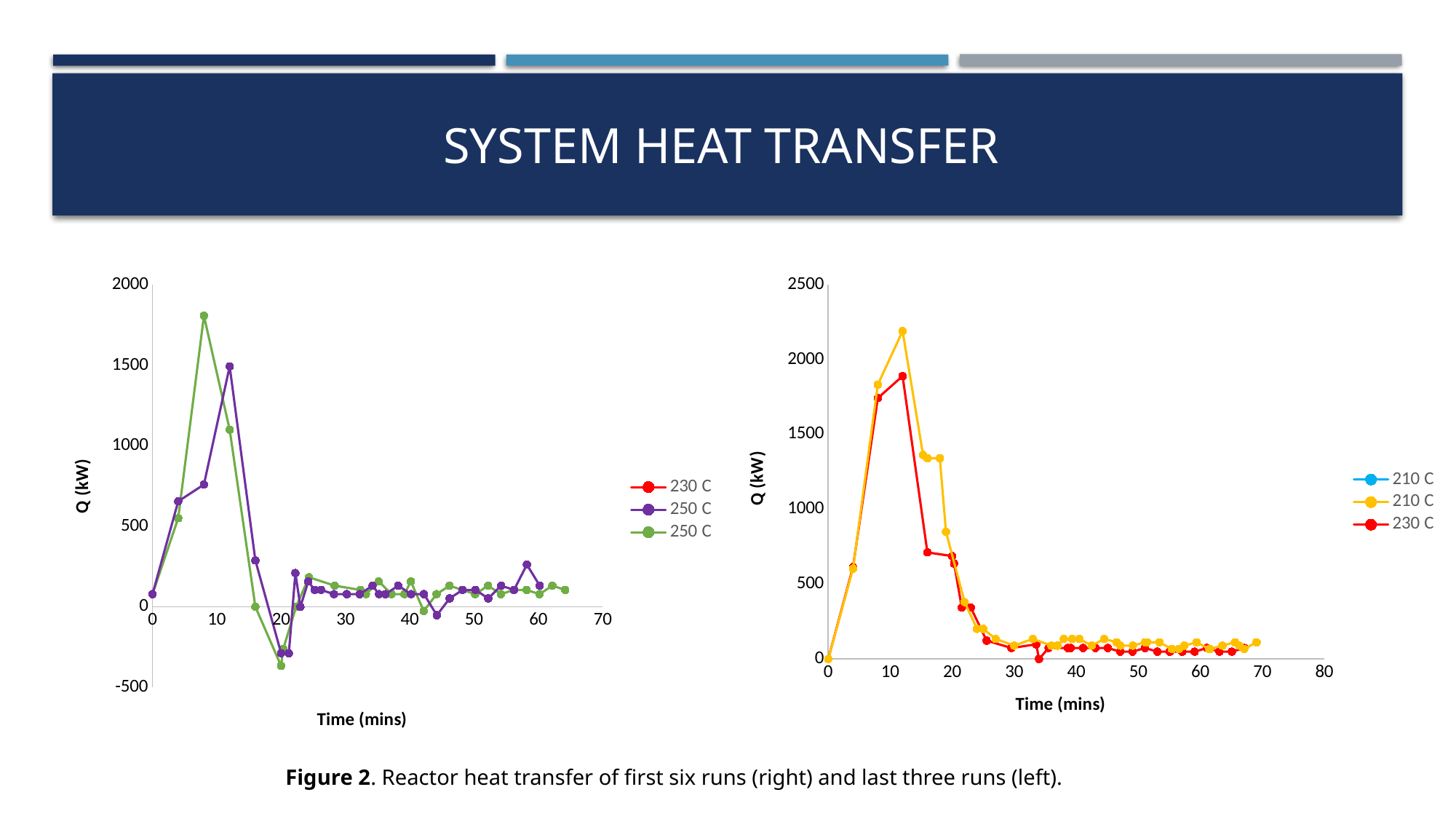
In the right chart, is the peak value of the yellow 210 C series greater or less than 2000? greater In the right chart, is the peak value of the red 230 C series greater or less than 1500? greater What is the y-axis label of the right chart? Q (kW) In the right chart, do the values rise or fall between 10 and 30 minutes? fall What is the x-axis label of the left chart? Time (mins) In the left chart, is the peak value of the green 250 C series greater or less than 1500? greater What type of chart is the left chart? line chart In the left chart, which series reaches the highest peak value? the green 250 C series How many series does the legend of the left chart list? 3 In the right chart, which series reaches the higher peak, the yellow 210 C series or the red 230 C series? 210 C How many series does the legend of the right chart list? 3